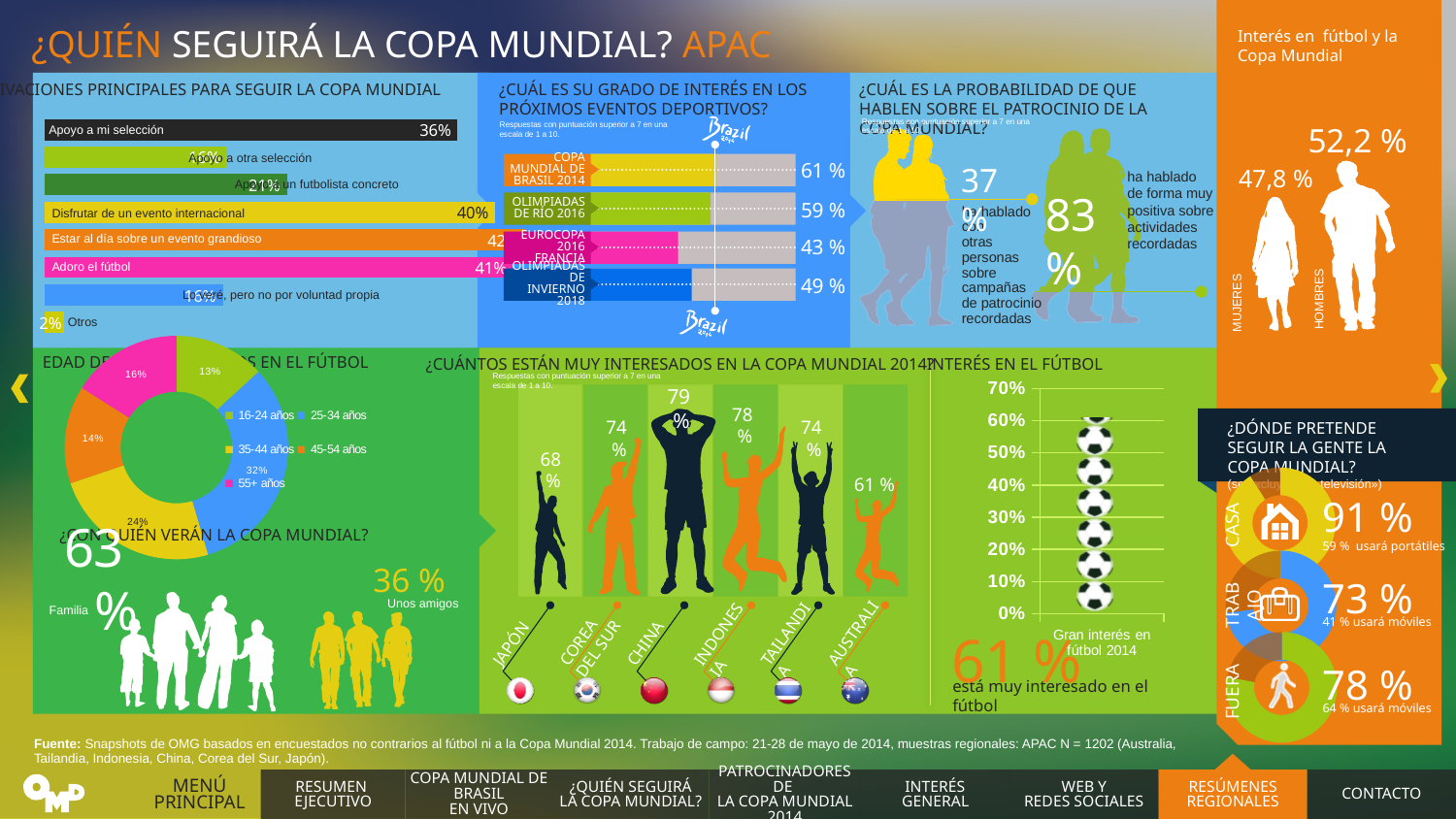
In the chart '¿Cuántos están muy interesados en la Copa Mundial 2014?', what is the value for Japón? 68 % In the chart '¿Cuántos están muy interesados en la Copa Mundial 2014?', how many countries are shown? 6 In the chart '¿Cuál es su grado de interés en los próximos eventos deportivos?', how many events are listed? 4 In the chart 'Motivaciones principales para seguir la Copa Mundial', what is the value for 'Apoyo a mi selección'? 36% In the chart '¿Cuántos están muy interesados en la Copa Mundial 2014?', which country has the highest value? China In the chart '¿Cuál es su grado de interés en los próximos eventos deportivos?', what is the value for Copa Mundial de Brasil 2014? 61 % In the chart 'Motivaciones principales para seguir la Copa Mundial', which is larger: 'Disfrutar de un evento internacional' or 'Apoyo a un futbolista concreto'? Disfrutar de un evento internacional In the chart '¿Con quién verán la Copa Mundial?', what is the value for Familia? 63 % In the chart '¿Cuál es su grado de interés en los próximos eventos deportivos?', which event has the lowest value? Eurocopa 2016 Francia In the chart '¿Cuál es su grado de interés en los próximos eventos deportivos?', what is the difference between Olimpiadas de Río 2016 and Olimpiadas de Invierno 2018? 10 % In the chart '¿Cuántos están muy interesados en la Copa Mundial 2014?', which country has the lowest value? Australia What kind of chart is 'Edad de los interesados en el fútbol'? Doughnut chart